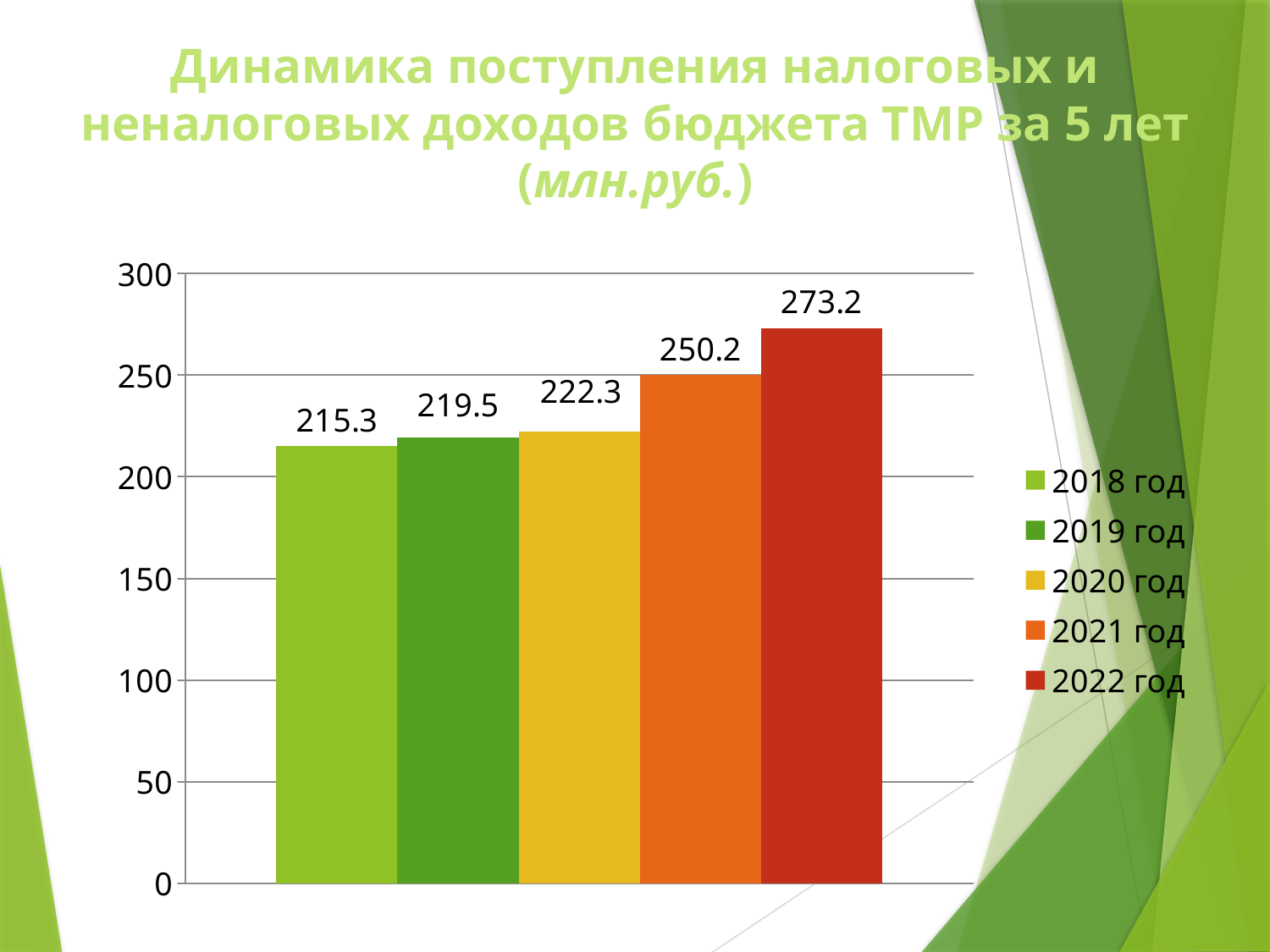
What is the value for 2020 год? 222.3 What is the value for 2018 год? 215.3 What kind of chart is shown on the slide? bar chart Is the value for 2022 год greater or less than 250? greater What is the difference between the values for 2019 год and 2018 год? 4.2 Which year has the highest value? 2022 год What is the difference between the values for 2022 год and 2021 год? 23.0 What is the value for 2021 год? 250.2 Which is larger, the value for 2020 год or the value for 2021 год? 2021 год Which year has the lowest value? 2018 год Do the values rise or fall from 2018 год to 2022 год? rise How many series does the legend list? 5